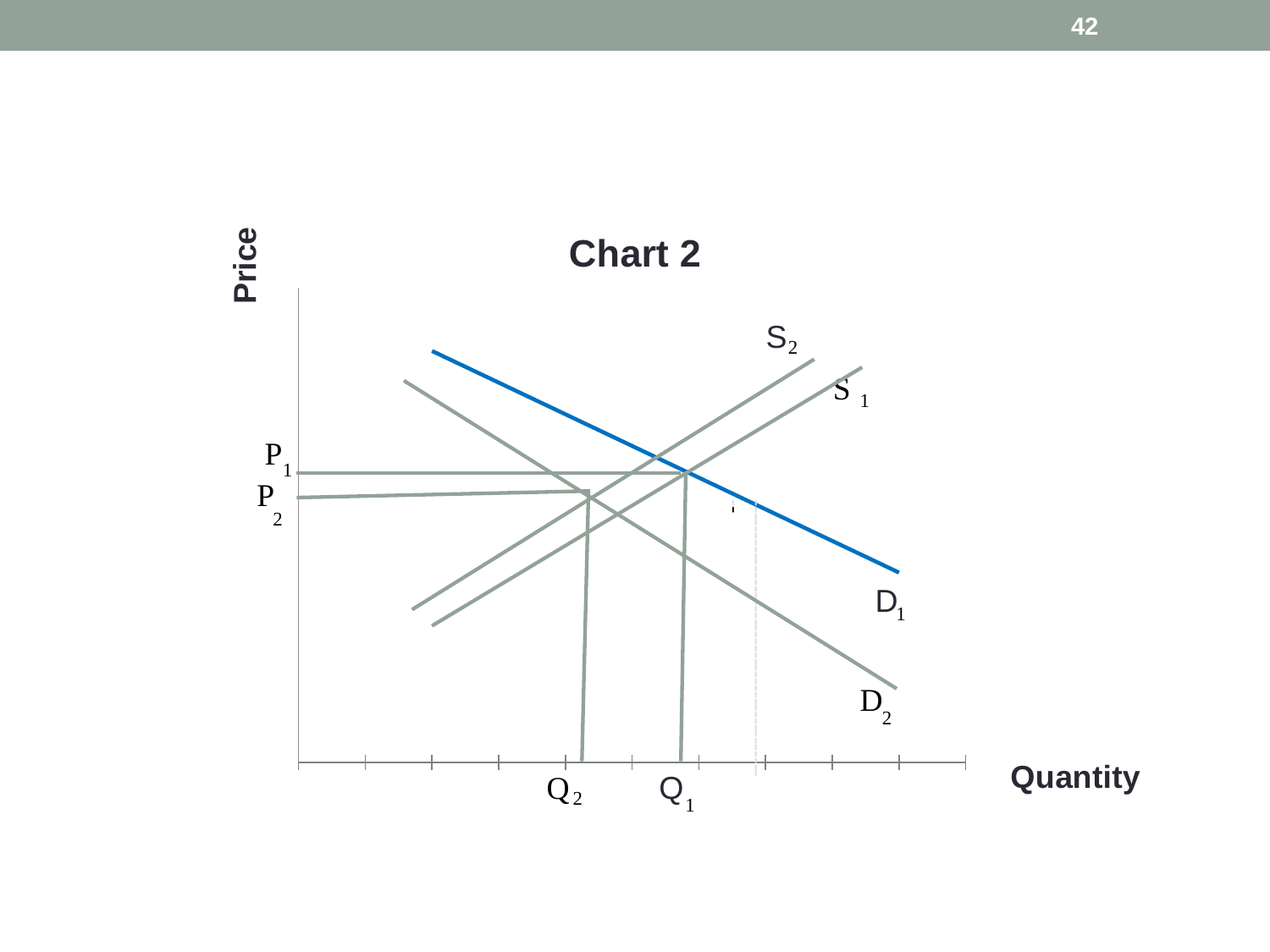
What kind of chart is shown on the slide? line chart Does the curve labelled D1 rise or fall as quantity increases? fall Which quantity is larger on the chart, Q1 or Q2? Q1 Does the curve labelled D2 rise or fall as quantity increases? fall Which price level is higher on the chart, P1 or P2? P1 What is the title of the chart on the slide? Chart 2 What label is on the vertical axis of the chart? Price Which curve on the chart is drawn in blue? D1 Does the curve labelled S2 rise or fall as quantity increases? rise How many curves (lines) are drawn in the chart? 4